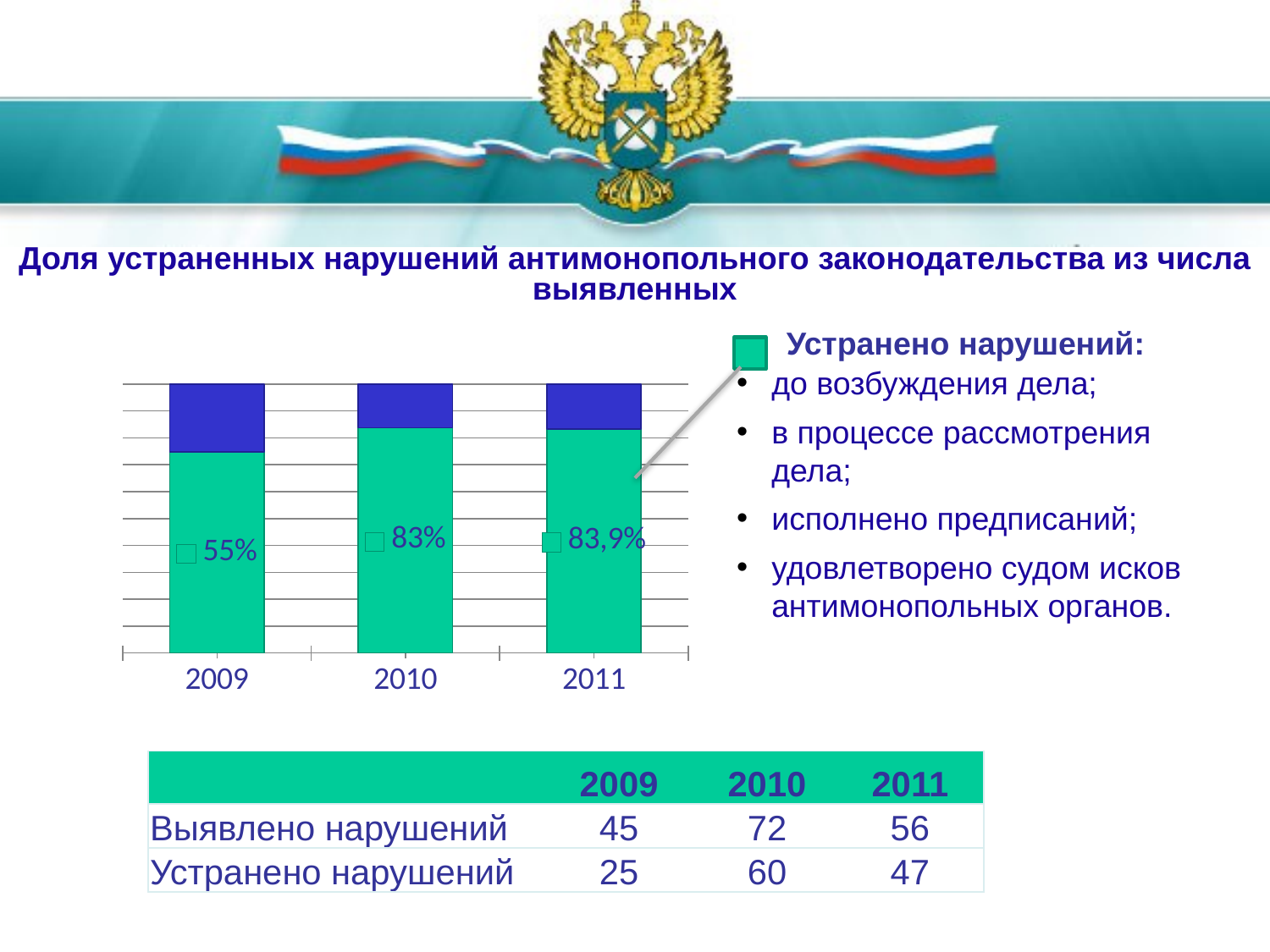
Which year has the lowest labelled share of eliminated violations? 2009 By how many percentage points does the labelled value for 2010 exceed that for 2009? 28 percentage points Which is larger, the labelled value for 2009 or for 2010? 2010 What is the labelled value for 2011 in the chart? 83,9% What is the title of the chart on the slide? Доля устраненных нарушений антимонопольного законодательства из числа выявленных How many years are shown on the x axis of the chart? 3 What is the labelled value for 2010 in the chart? 83% Do the labelled values rise or fall from 2009 to 2011? Rise What does the green segment of the bars represent, according to the legend? Устранено нарушений What is the labelled value for 2009 in the chart? 55% What kind of chart is shown on the slide? Stacked bar chart Which year has the highest labelled share of eliminated violations? 2011